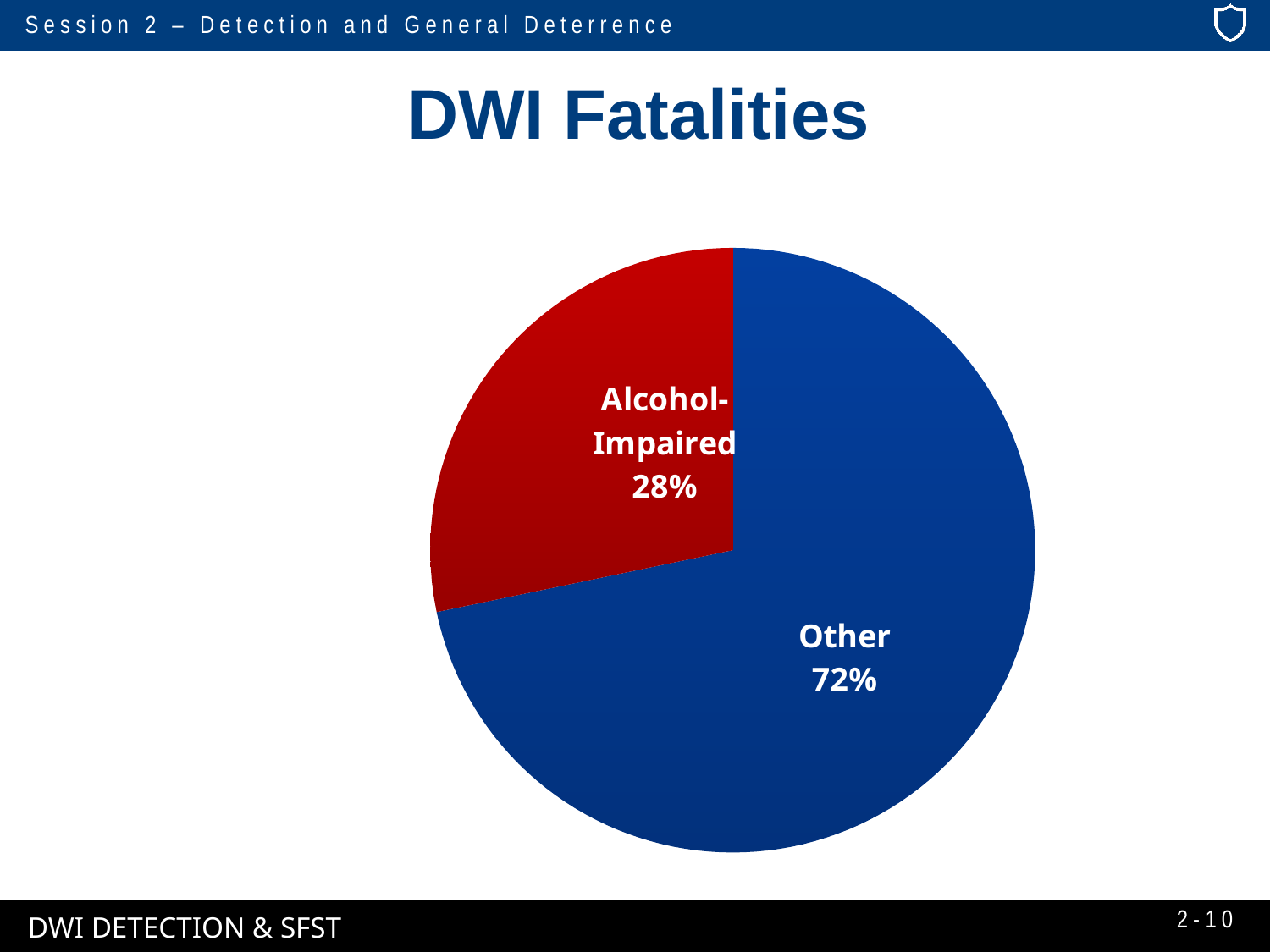
What is the total of the two slice percentages shown? 100% What colour is the Alcohol-Impaired slice? red Which is larger, the Alcohol-Impaired slice or the Other slice? Other What is the title of the chart? DWI Fatalities How many slices does the pie chart have? 2 What is the difference in percentage points between the Other slice and the Alcohol-Impaired slice? 44 What kind of chart is shown on the slide? pie chart Which slice of the pie is the largest? Other What share of DWI fatalities is labelled Alcohol-Impaired? 28% Which slice of the pie is the smallest? Alcohol-Impaired What share of DWI fatalities is labelled Other? 72%